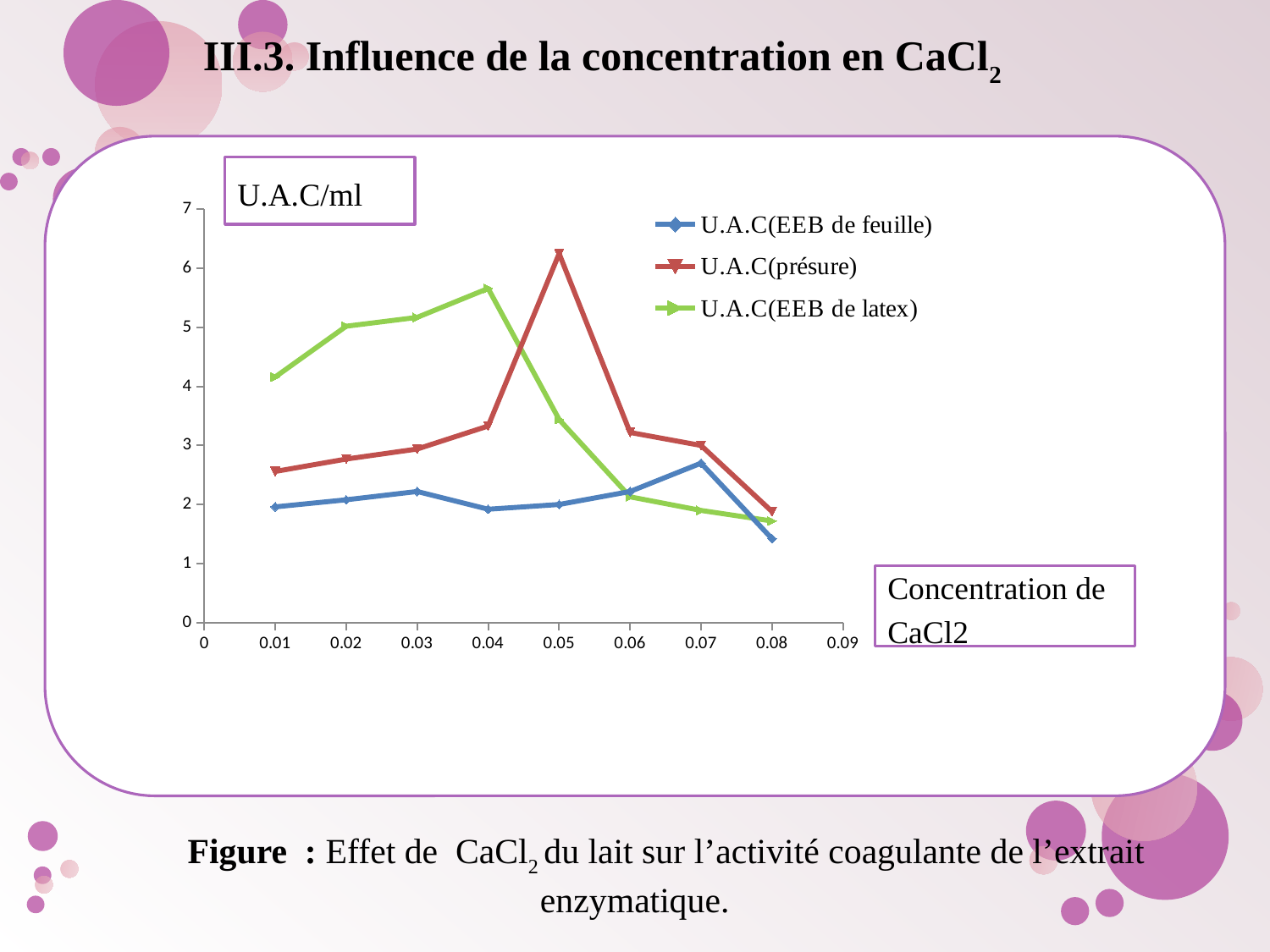
At concentration 0.02, which is larger: U.A.C(EEB de latex) or U.A.C(EEB de feuille)? U.A.C(EEB de latex) Which series reaches the highest value on the chart? U.A.C(présure) At which CaCl2 concentration does U.A.C(EEB de latex) reach its peak? 0.04 Is the value of U.A.C(EEB de latex) at concentration 0.04 greater or less than 5? greater Is the value of U.A.C(présure) at concentration 0.05 greater or less than 6? greater How many concentration points are plotted for each series? 8 Is the value of U.A.C(EEB de feuille) at concentration 0.08 greater or less than 2? less How many series does the legend list? 3 What label is shown for the vertical axis of the chart? U.A.C/ml What kind of chart is shown on the slide? line chart At which CaCl2 concentration does U.A.C(présure) reach its peak? 0.05 Does U.A.C(présure) rise or fall between concentrations 0.05 and 0.08? fall